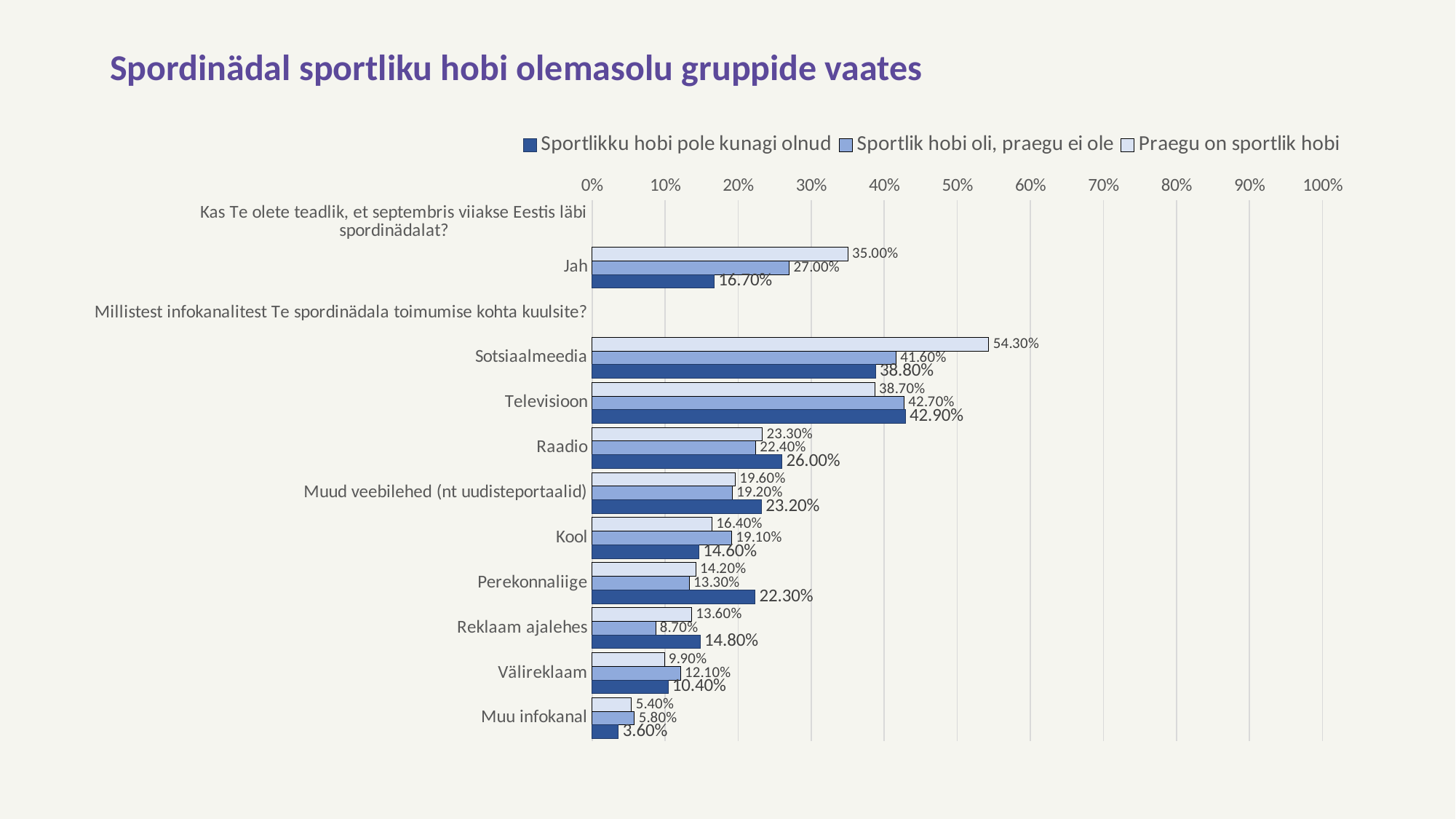
What is the value for Sotsiaalmeedia in the 'Praegu on sportlik hobi' series? 54.30% What is the value for Jah in the 'Sportlikku hobi pole kunagi olnud' series? 16.70% What kind of chart is shown on the slide? bar chart How many series does the legend list? 3 What is the difference between the 'Praegu on sportlik hobi' and 'Sportlikku hobi pole kunagi olnud' values for Jah? 18.30% Which information channel has the highest value in the 'Praegu on sportlik hobi' series? Sotsiaalmeedia Which information channel has the lowest value in the 'Sportlikku hobi pole kunagi olnud' series? Muu infokanal What is the title of the chart? Spordinädal sportliku hobi olemasolu gruppide vaates What is the value for Televisioon in the 'Sportlik hobi oli, praegu ei ole' series? 42.70% Is the value for Sotsiaalmeedia in the 'Praegu on sportlik hobi' series greater or less than 50%? greater For Perekonnaliige, which series has the larger value: 'Sportlikku hobi pole kunagi olnud' or 'Praegu on sportlik hobi'? Sportlikku hobi pole kunagi olnud How many information channels are listed under 'Millistest infokanalitest Te spordinädala toimumise kohta kuulsite?' 9